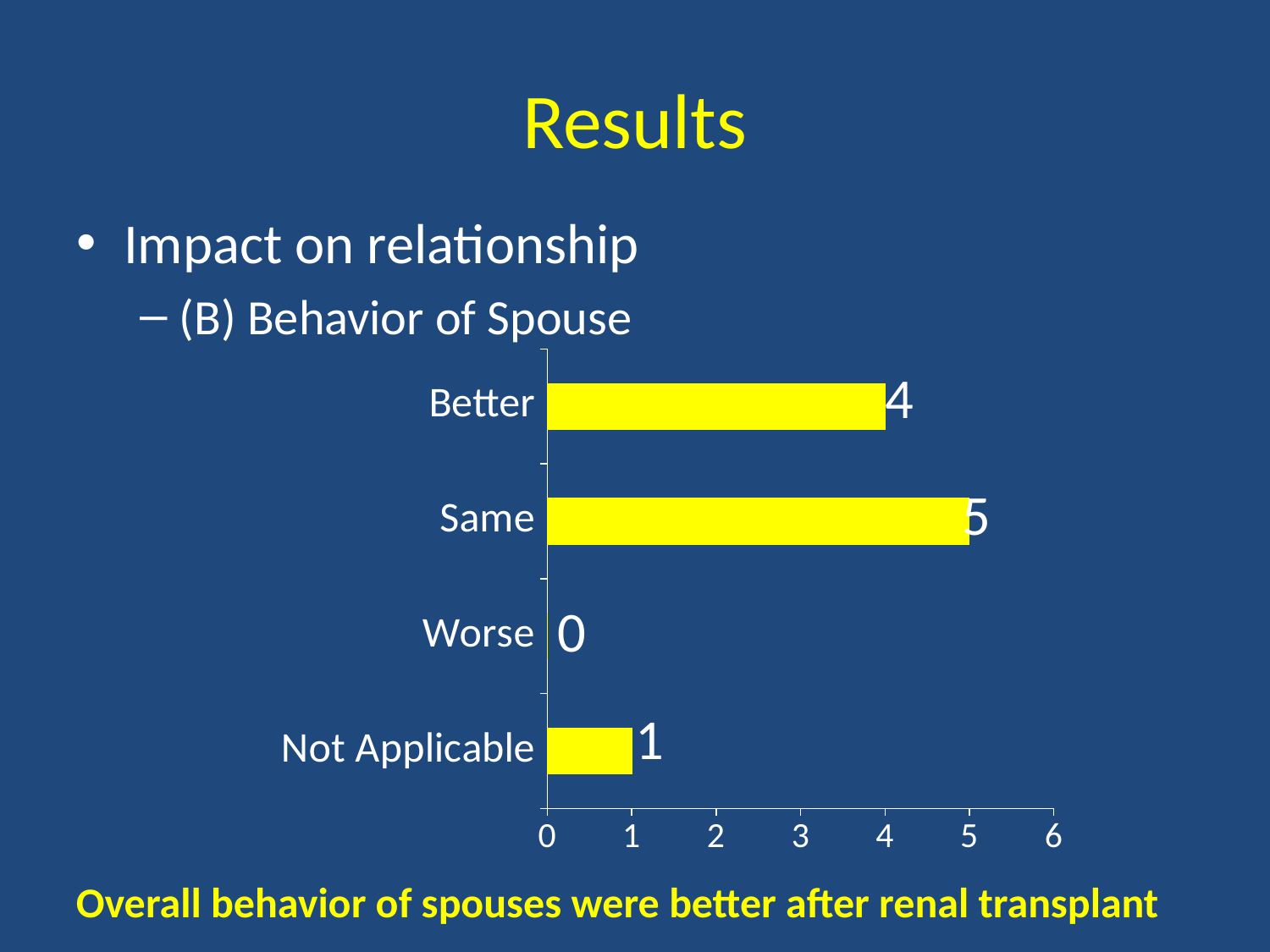
What is the maximum value shown on the x axis? 6 Which category has the highest value? Same What is the value for Not Applicable? 1 How many categories are shown in the chart? 4 What is the value for Worse? 0 What kind of chart is shown on the slide? Bar chart What is the value for Same? 5 Which is larger, the value for Better or the value for Not Applicable? Better What is the difference between the values for Better and Not Applicable? 3 What is the value for Better? 4 Which category has the lowest value? Worse What is the difference between the values for Same and Better? 1